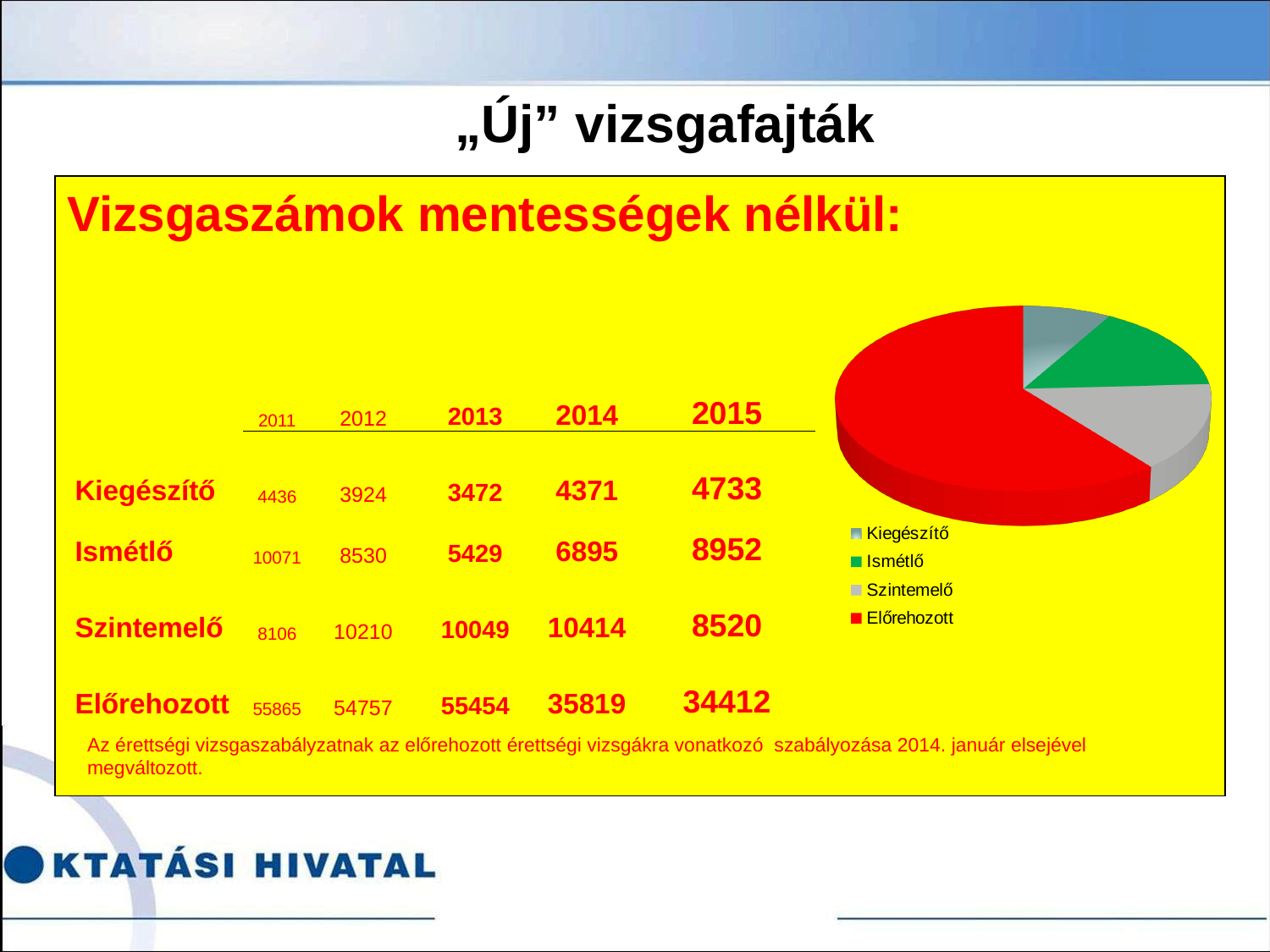
In the pie chart, which slice is larger: Kiegészítő or Ismétlő? Ismétlő In the table on the slide, what is the value for Kiegészítő in 2013? 3472 In the table on the slide, what is the value for Szintemelő in 2014? 10414 In the table on the slide, what is the value for Előrehozott in 2015? 34412 How many categories does the legend of the pie chart list? 4 What colour is the Előrehozott slice in the pie chart? red Which category has the largest slice in the pie chart? Előrehozott In the table on the slide, how many years are listed? 5 What colour is the Ismétlő slice in the pie chart? green Which category has the smallest slice in the pie chart? Kiegészítő In the pie chart, which slice is larger: Előrehozott or Szintemelő? Előrehozott What kind of chart is shown on the right side of the slide? pie chart